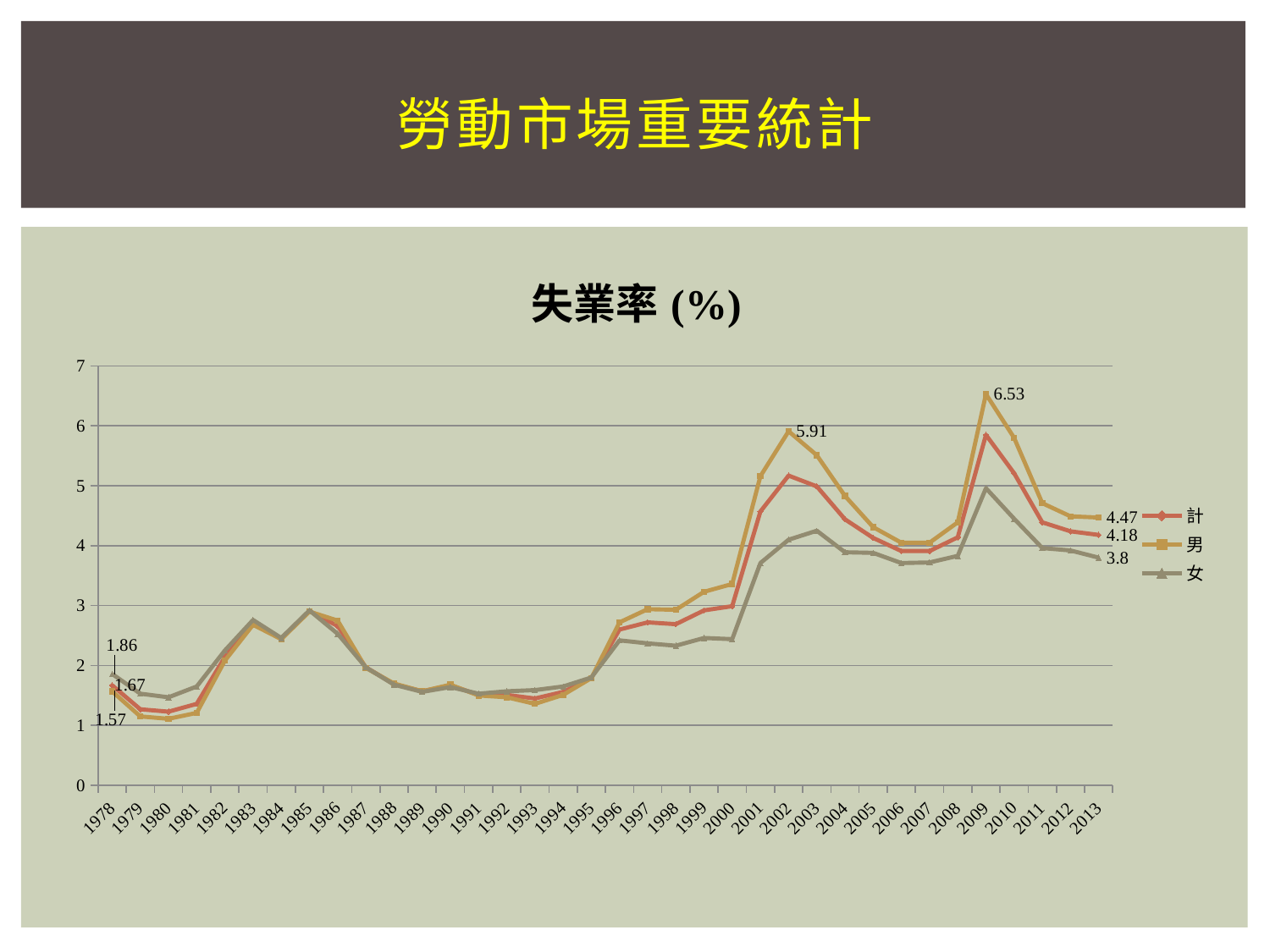
What is the value for 女 in 2013? 3.8 What is the difference between the 男 and 女 values in 2013? 0.67 What is the value for 男 in 2002? 5.91 What is the title of the chart? 失業率 (%) Which series has the highest value in 2009? 男 How many series does the legend list? 3 Is the value for 女 in 2009 greater or less than 4? greater Which is larger in 1978, the value for 女 or the value for 男? 女 What is the value for 男 in 2009? 6.53 What is the value for 計 in 2013? 4.18 What is the value for 男 in 1978? 1.57 What type of chart is shown on the slide? line chart